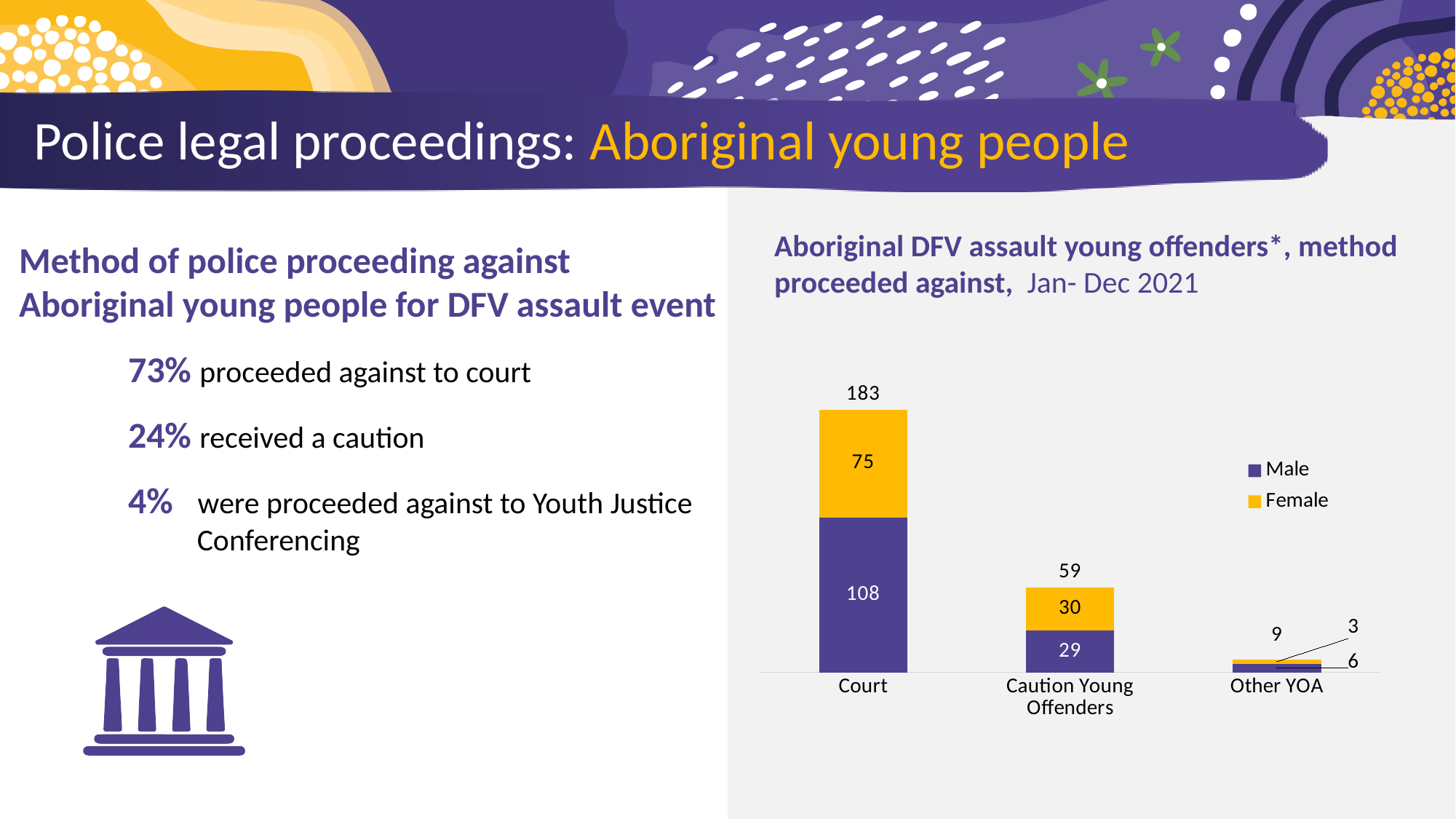
What is the Female value for Caution Young Offenders? 30 Which category has the highest total? Court What is the total of the stacked bar for Court? 183 What is the difference between the Male and Female values for Court? 33 What is the total of the stacked bar for Caution Young Offenders? 59 How many series does the legend list? 2 How many categories are shown on the x axis? 3 What kind of chart is shown on the slide? Stacked bar chart What is the Male value for Court? 108 Which is larger for Other YOA, the Male value or the Female value? Male What is the Female value for Other YOA? 3 Which category has the lowest total? Other YOA